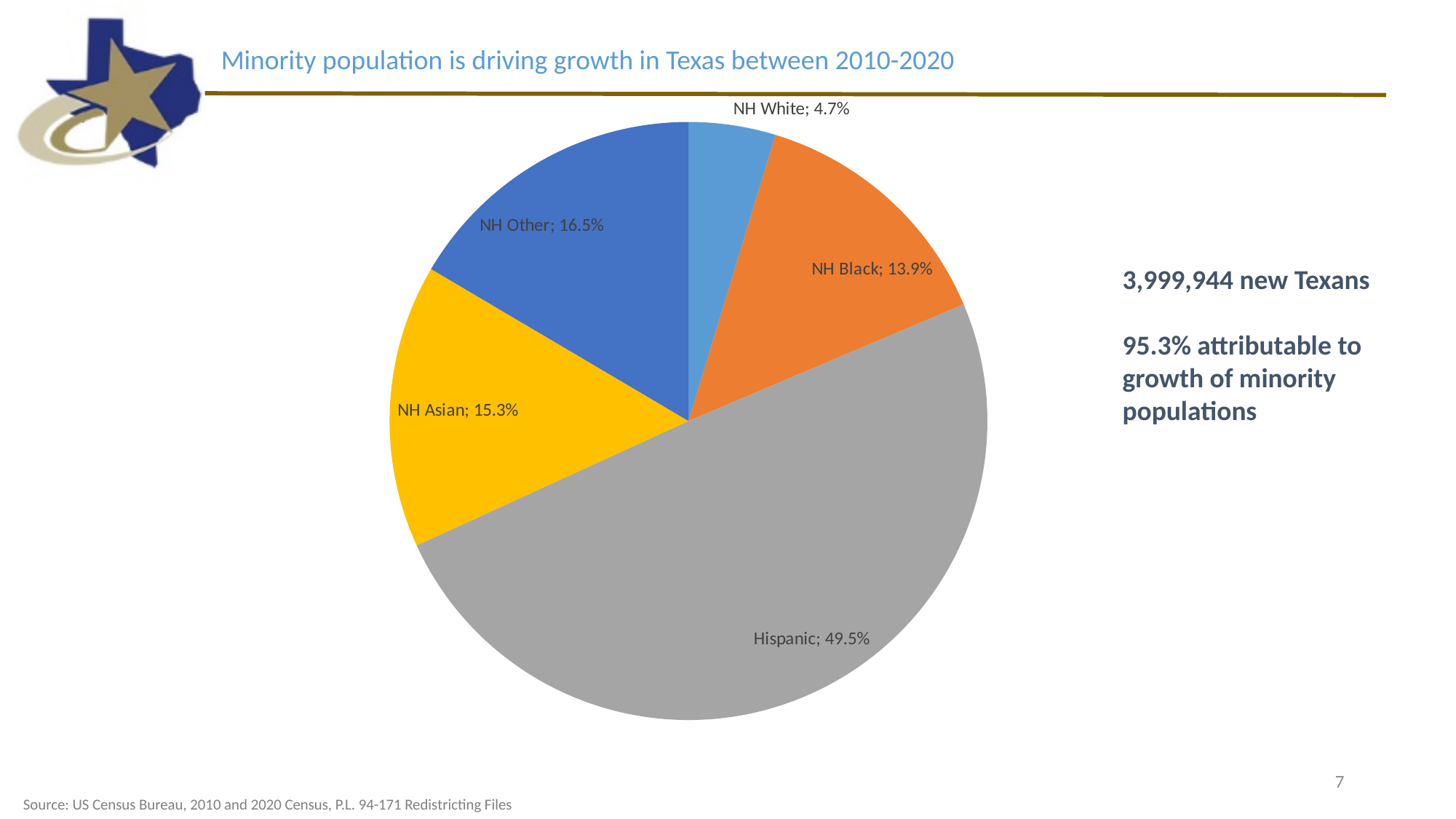
Which is larger, the NH Black slice or the NH Asian slice? NH Asian What share of the pie does Hispanic account for? 49.5% What is the difference between the NH Other and NH Asian shares? 1.2% What is the value shown for NH Asian? 15.3% Which category has the largest slice of the pie? Hispanic Which category has the smallest slice of the pie? NH White What is the value shown for NH Black? 13.9% How many slices does the pie chart have? 5 What is the difference between the Hispanic and NH White shares? 44.8% What kind of chart is shown on the slide? pie chart What is the value shown for NH White? 4.7% What colour is the Hispanic slice of the pie? grey